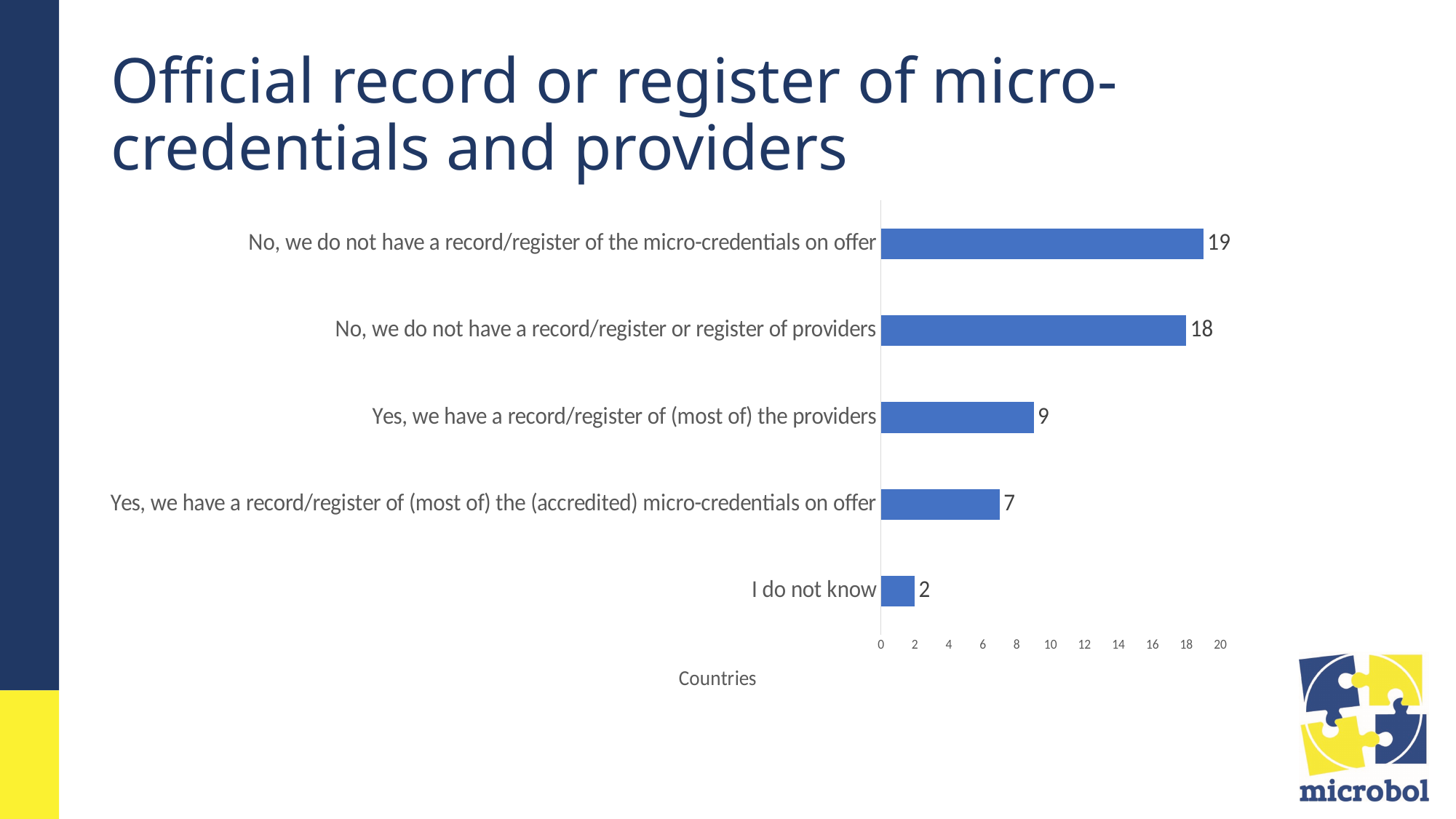
What is the difference between the values for "Yes, we have a record/register of (most of) the providers" and "I do not know"? 7 What is the value for "Yes, we have a record/register of (most of) the providers"? 9 What is the value for "Yes, we have a record/register of (most of) the (accredited) micro-credentials on offer"? 7 Which is larger: the value for "Yes, we have a record/register of (most of) the providers" or for "Yes, we have a record/register of (most of) the (accredited) micro-credentials on offer"? Yes, we have a record/register of (most of) the providers How many countries answered "No, we do not have a record/register of the micro-credentials on offer"? 19 What is the difference between the values for "No, we do not have a record/register of the micro-credentials on offer" and "No, we do not have a record/register or register of providers"? 1 Which category has the highest value? No, we do not have a record/register of the micro-credentials on offer What is the label on the horizontal axis of the chart? Countries What kind of chart is shown on the slide? Bar chart How many categories are shown in the chart? 5 Which category has the lowest value? I do not know What is the value for "I do not know"? 2